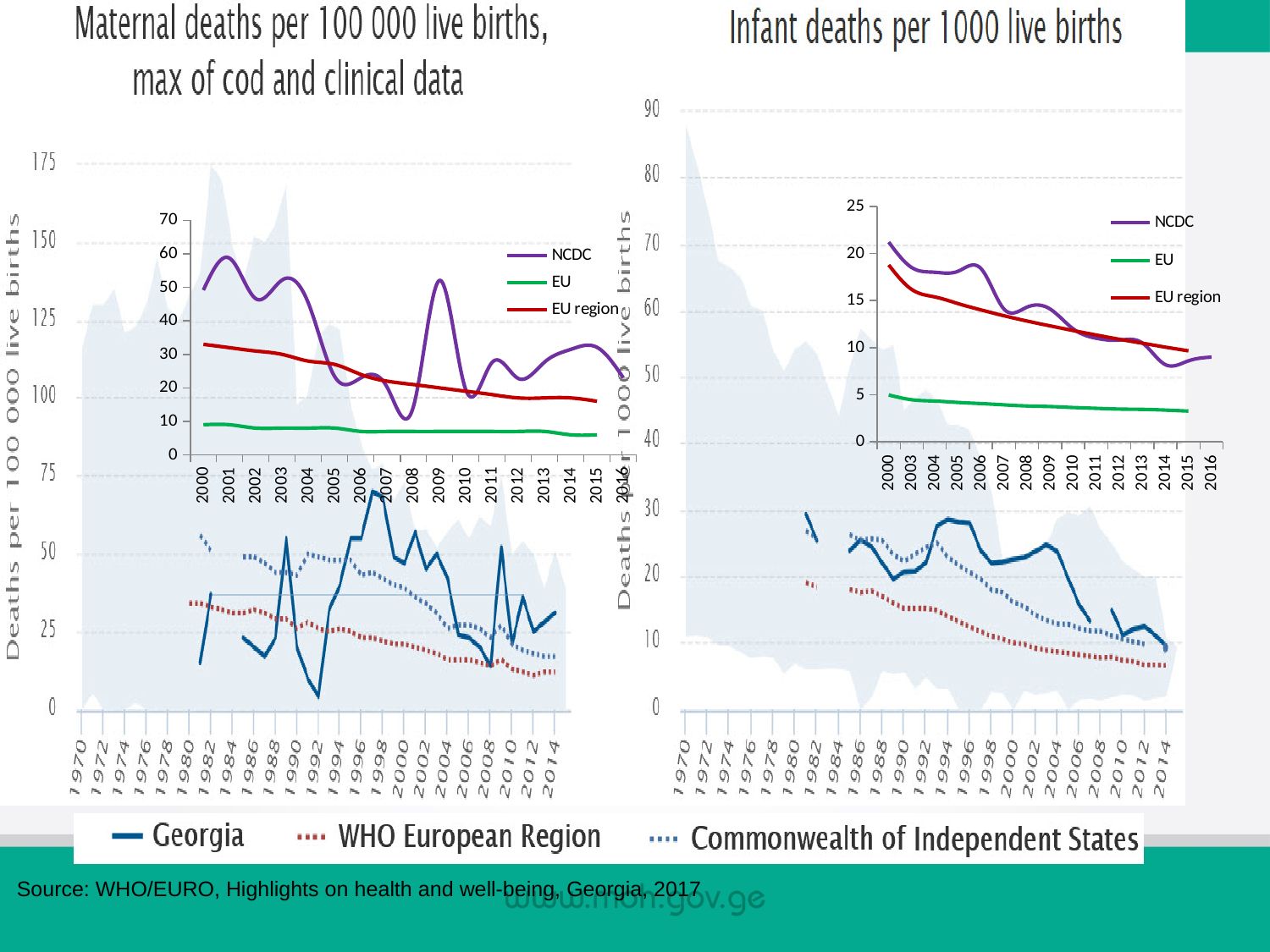
How many series does the legend of the left inset chart (Maternal deaths) list? 3 In the left inset chart (Maternal deaths), which is larger in 2009, NCDC or EU region? NCDC In the right inset chart (Infant deaths), which is larger in 2006, NCDC or EU region? NCDC In the right inset chart (Infant deaths), which series is the lowest across all years? EU In the left inset chart (Maternal deaths), which series is the lowest across all years? EU How many series does the legend at the bottom of the slide (Georgia, WHO European Region, Commonwealth of Independent States) list? 3 In the right inset chart (Infant deaths), does the NCDC line rise or fall from 2000 to 2016? fall In the left inset chart (Maternal deaths), is the NCDC value for 2008 greater or less than 20? less In the left inset chart (Maternal deaths), is the NCDC value for 2001 greater or less than 50? greater What kind of chart is the inset chart on the left slide (Maternal deaths, NCDC/EU/EU region)? line chart How many years are shown on the x axis of the right inset chart (Infant deaths, 2000 to 2016)? 15